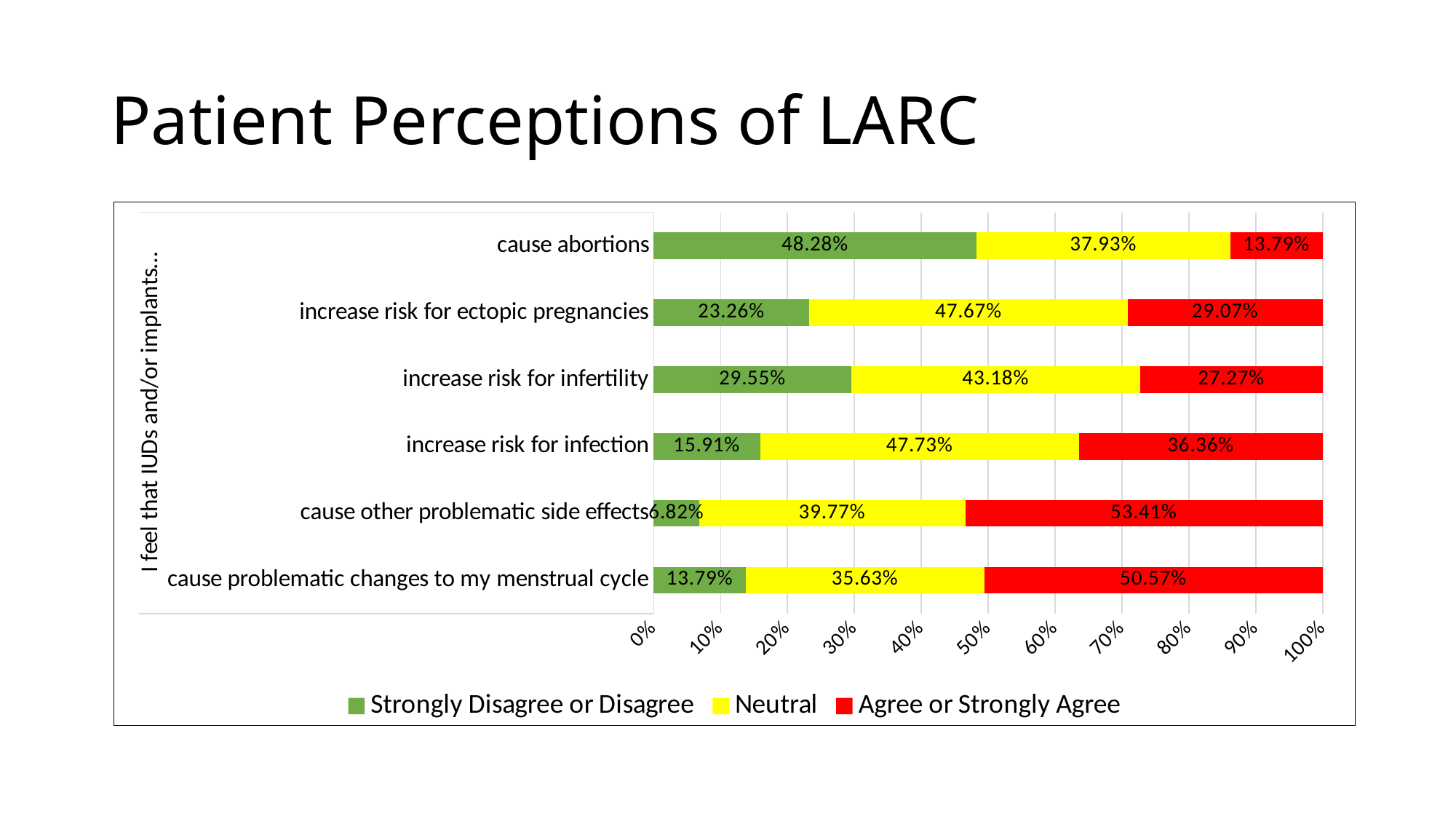
Which has a larger Agree or Strongly Agree value: 'increase risk for infection' or 'increase risk for infertility'? increase risk for infection Which statement has the lowest Strongly Disagree or Disagree percentage? cause other problematic side effects Which colour represents the Neutral series in the chart? Yellow What percentage of respondents were Neutral on the statement that IUDs and/or implants increase risk for infertility? 43.18% What is the Agree or Strongly Agree value for 'cause other problematic side effects'? 53.41% What type of chart is shown on the slide? Stacked bar chart How many statements (categories) are shown in the chart? 6 What is the difference between the Strongly Disagree or Disagree and Agree or Strongly Agree values for 'cause abortions'? 34.49% What is the Strongly Disagree or Disagree value for 'increase risk for ectopic pregnancies'? 23.26% Which statement has the highest Strongly Disagree or Disagree percentage? cause abortions Which statement has the highest Agree or Strongly Agree percentage? cause other problematic side effects How many series does the legend list? 3